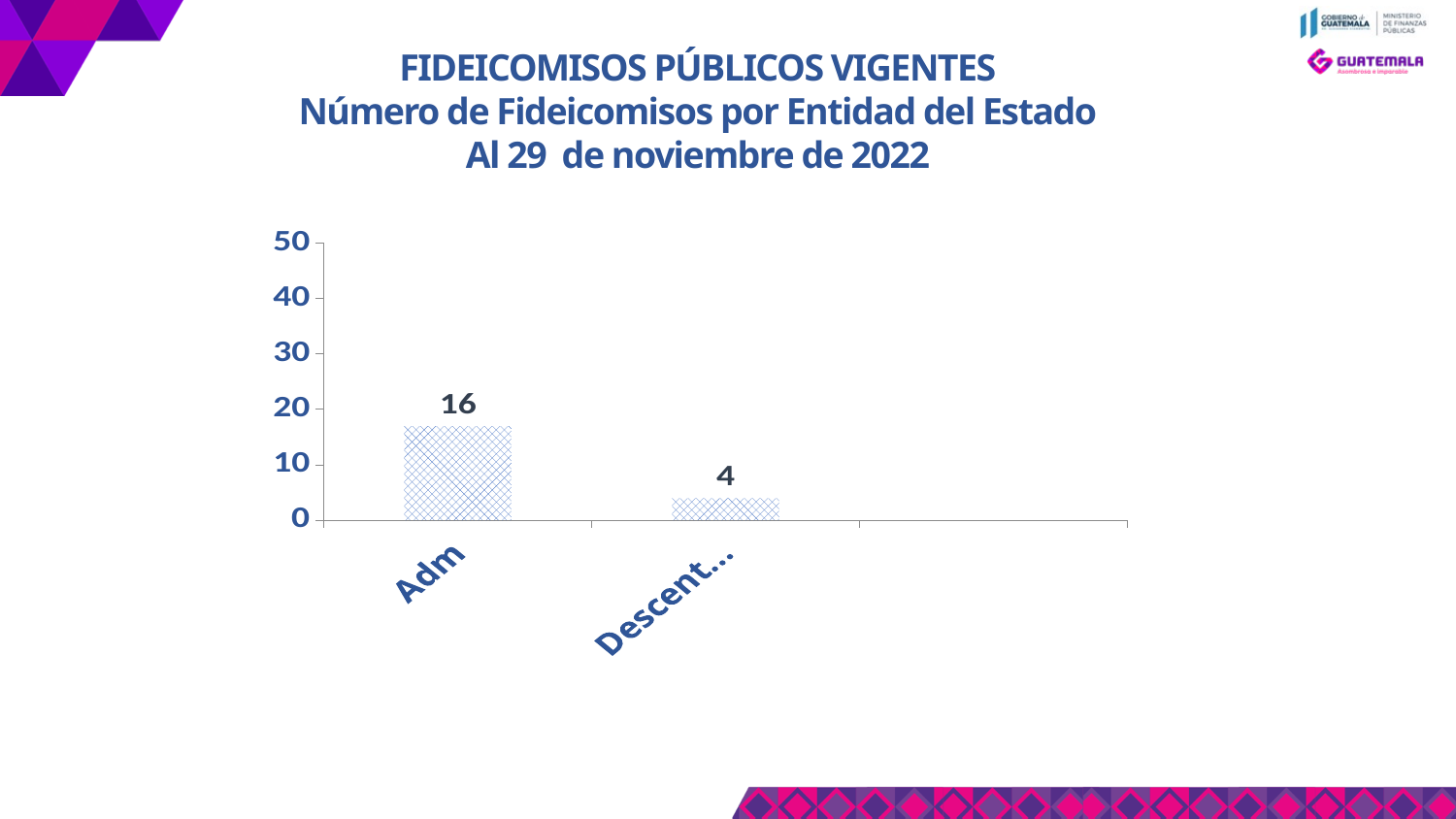
Which category has the lowest value? Descent... Which is larger, the value for Adm or the value for Descent...? Adm What is the value for Adm? 16 How many bars are plotted in the chart? 2 What date does the chart title say the data is as of? 29 de noviembre de 2022 Is the value for Descent... greater or less than 10? less What is the value for the category labelled "Descent..."? 4 What kind of chart is shown on the slide? bar chart Which category has the highest value? Adm Is the value for Adm greater or less than 20? less What is the maximum value shown on the vertical axis? 50 What is the difference between the value for Adm and the value for Descent...? 12